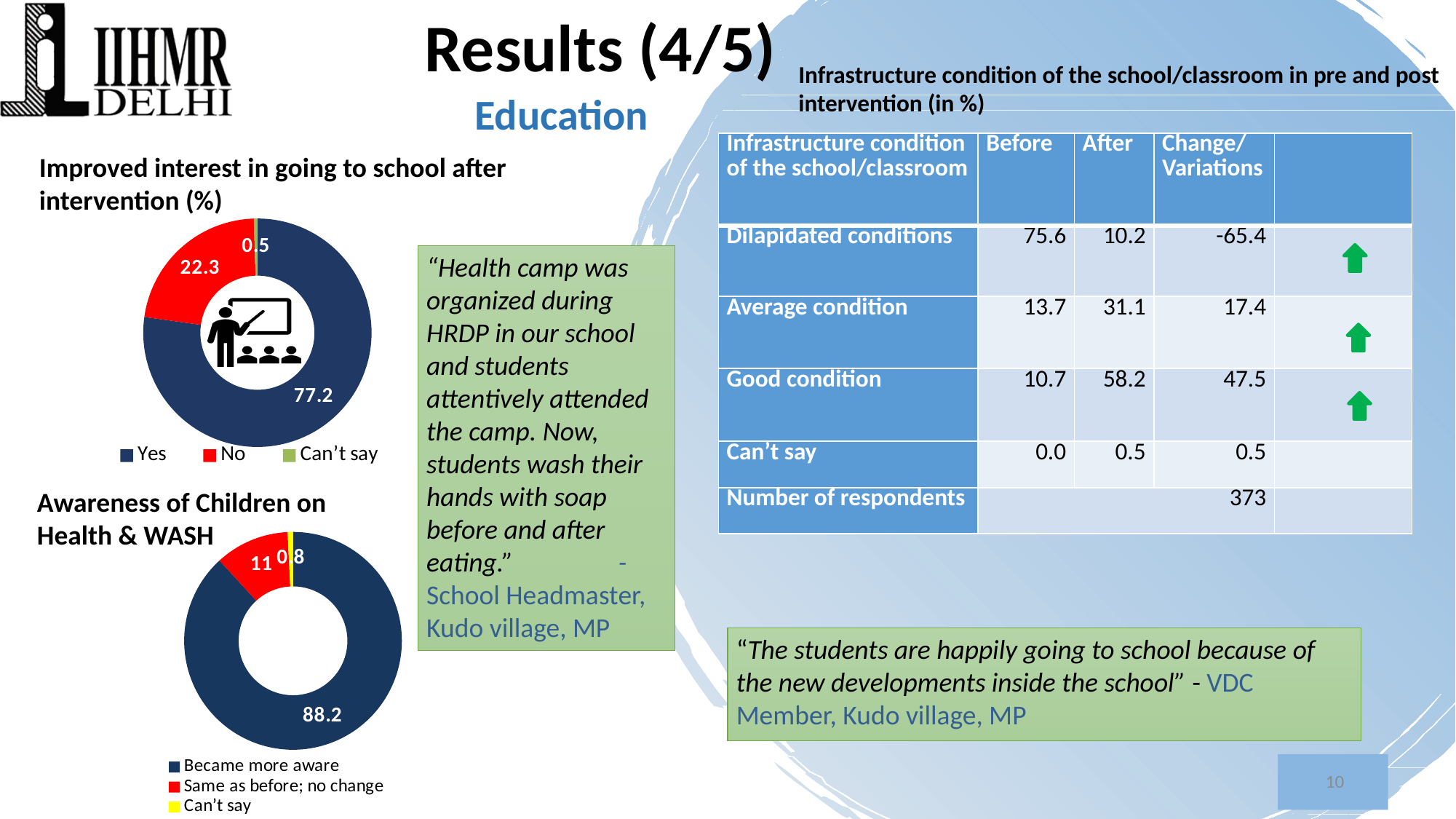
In the 'Awareness of Children on Health & WASH' chart, which is larger: 'Same as before; no change' or 'Can't say'? Same as before; no change In the 'Awareness of Children on Health & WASH' chart, which category has the smallest share? Can't say In the 'Improved interest in going to school after intervention (%)' chart, what is the value for Yes? 77.2 In the 'Improved interest in going to school after intervention (%)' chart, what is the value for Can't say? 0.5 How many categories does the legend of the 'Improved interest in going to school after intervention (%)' chart list? 3 In the 'Improved interest in going to school after intervention (%)' chart, what is the value for No? 22.3 In the 'Awareness of Children on Health & WASH' chart, what is the value for 'Same as before; no change'? 11 In the 'Awareness of Children on Health & WASH' chart, what colour represents 'Can't say'? Yellow In the 'Improved interest in going to school after intervention (%)' chart, which category has the largest share? Yes In the 'Awareness of Children on Health & WASH' chart, what is the value for 'Became more aware'? 88.2 In the 'Improved interest in going to school after intervention (%)' chart, what is the difference between the Yes and No values? 54.9 What type of chart is the 'Awareness of Children on Health & WASH' chart? Doughnut chart